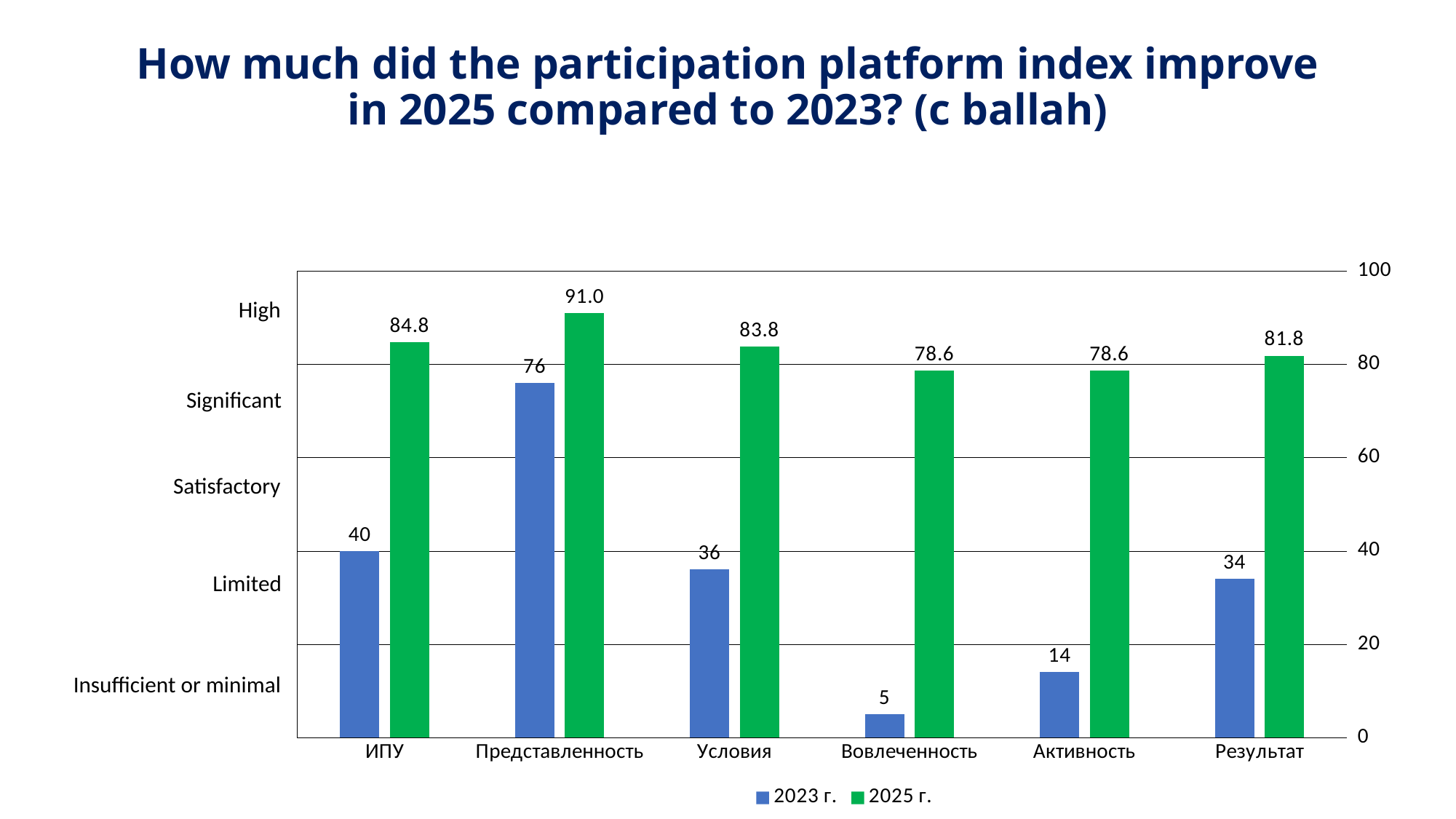
What is the 2025 г. value for Результат? 81.8 What is the 2025 г. value for ИПУ? 84.8 How many categories are shown on the x axis? 6 Which category has the highest 2025 г. value? Представленность Which is larger, the 2023 г. value for Условия or the 2023 г. value for Результат? Условия Which colour represents the 2025 г. series? Green What kind of chart is shown on the slide? Bar chart What is the difference between the 2025 г. and 2023 г. values for Активность? 64.6 What is the 2023 г. value for Представленность? 76 How many series does the legend list? 2 What is the 2023 г. value for Вовлеченность? 5 Which category has the lowest 2023 г. value? Вовлеченность